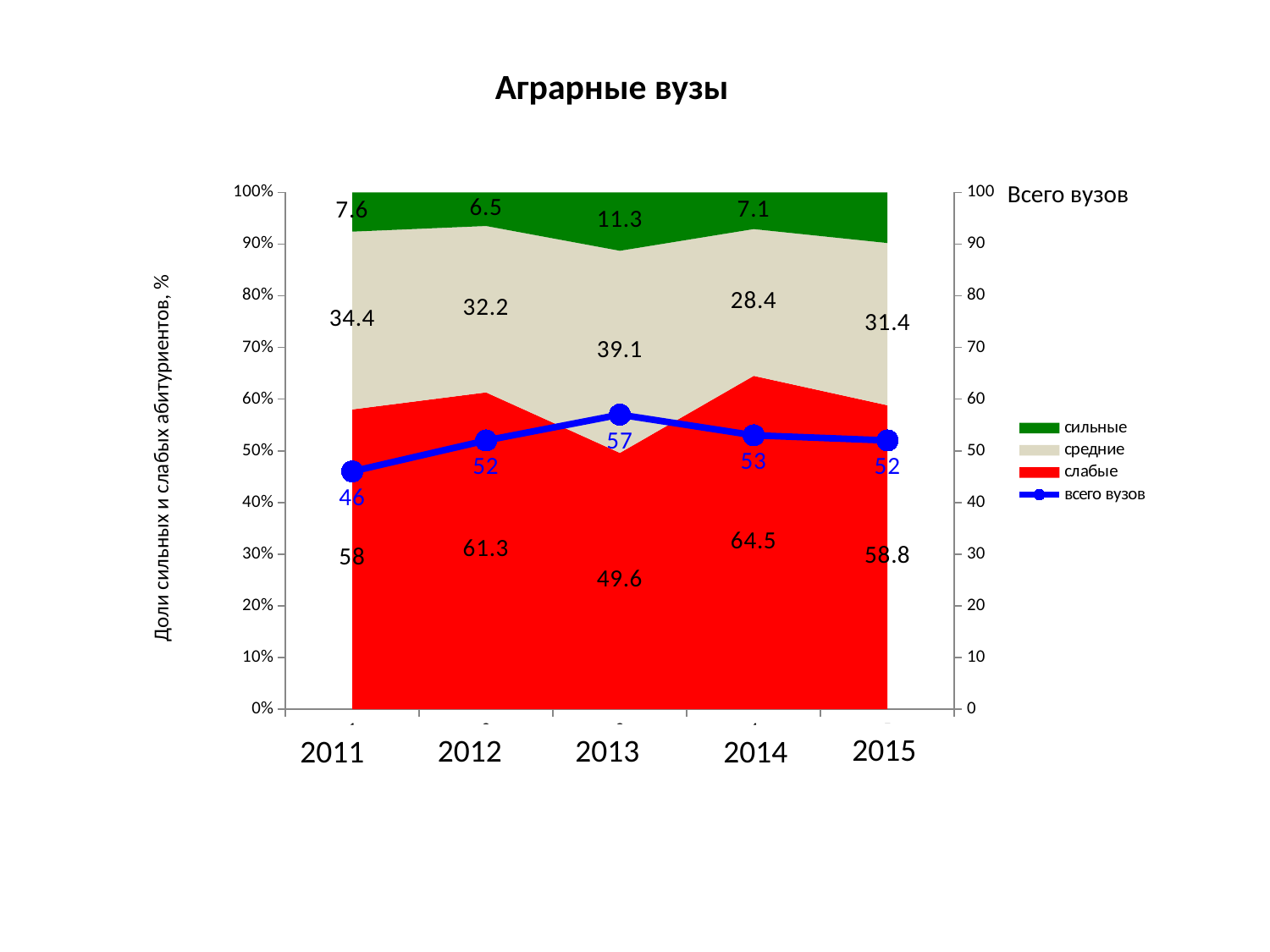
What is the value for слабые in 2014? 64.5 In which year is the value for слабые lowest? 2013 Which is larger, the средние value in 2011 or in 2015? 2011 What is the title of the chart? Аграрные вузы In which year is the value for всего вузов highest? 2013 What is the value of всего вузов in 2011? 46 What is the value for средние in 2013? 39.1 In which year is the value for сильные highest? 2013 What is the value for сильные in 2012? 6.5 How many series does the legend list? 4 What is the difference between the слабые values in 2014 and 2013? 14.9 How many years are shown on the x axis? 5